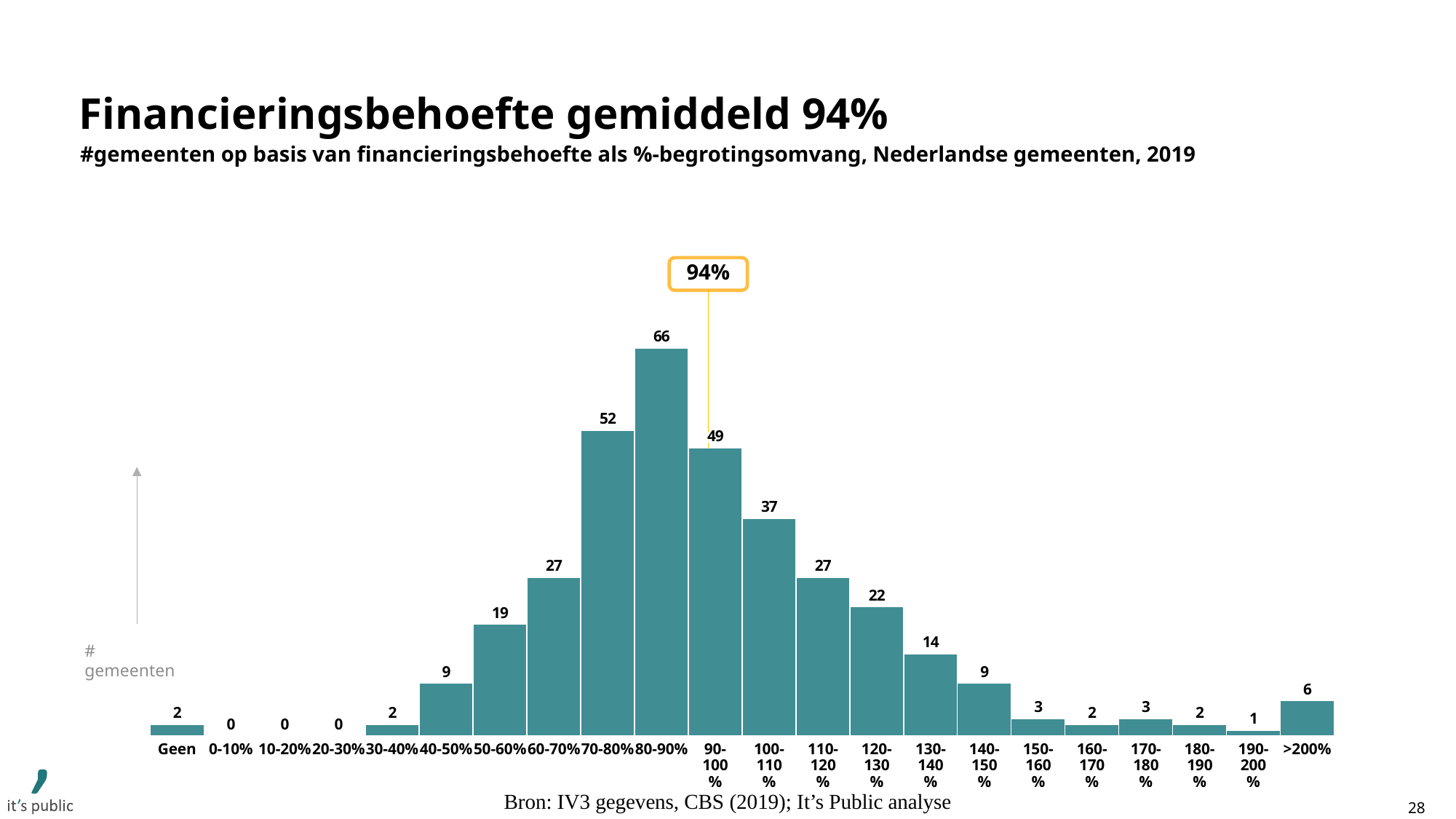
Which category has the highest number of municipalities? 80-90% What is the difference between the values for 70-80% and 60-70%? 25 What is the value for the 120-130% category? 22 What average value is highlighted in the callout box above the chart? 94% Which is larger, the value for 100-110% or the value for 110-120%? 100-110% What is the difference between the values for 80-90% and 90-100%? 17 What kind of chart is shown on the slide? bar chart Do the values rise or fall from 80-90% to 140-150%? fall What is the value for the 'Geen' category? 2 How many categories are shown on the x axis? 22 What is the value for the >200% category? 6 How many municipalities fall in the 80-90% category? 66